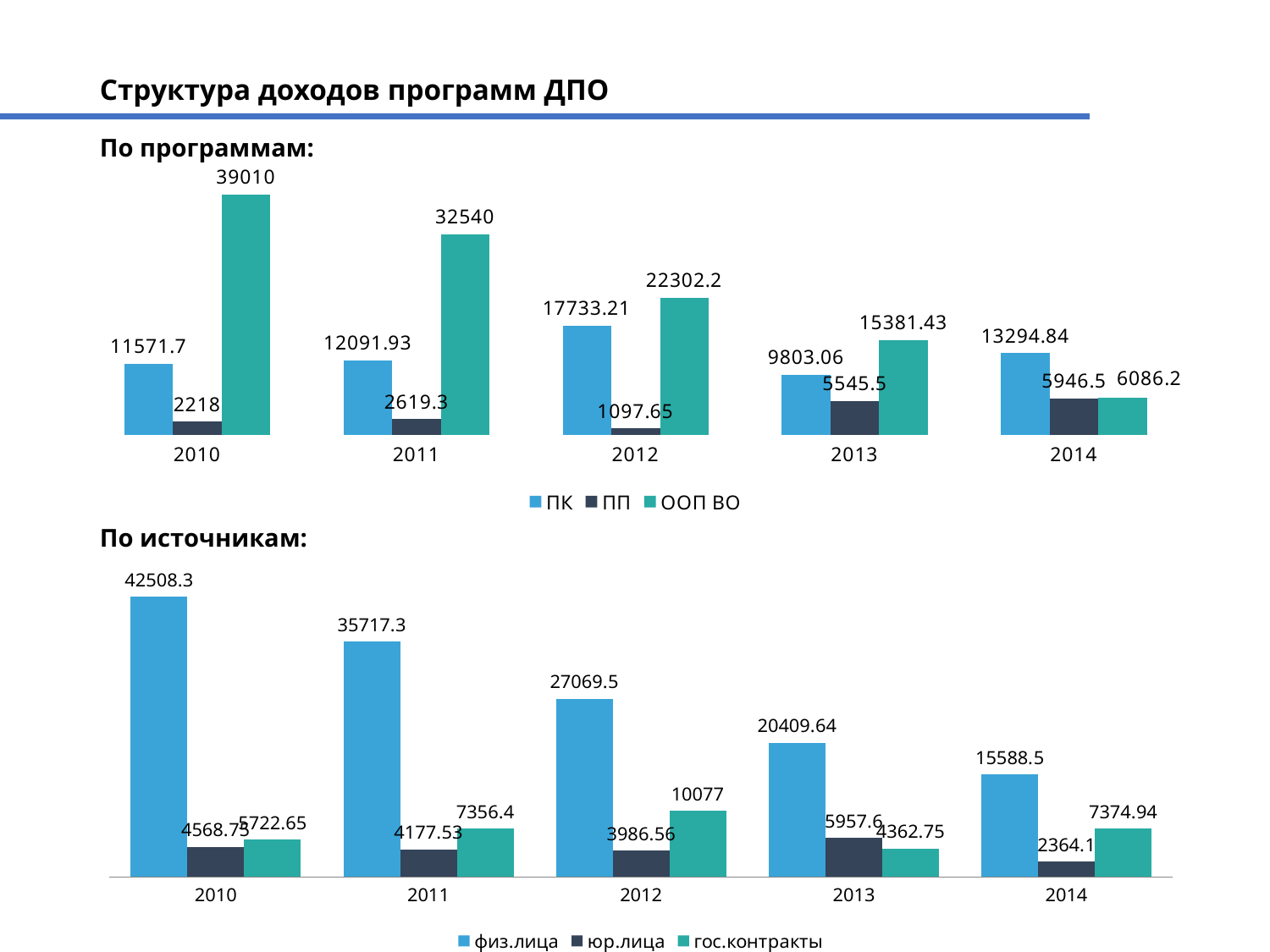
In the 'По программам' chart, which year has the lowest value for ПП? 2012 In the 'По программам' chart, what is the value for ООП ВО in 2010? 39010 In the 'По источникам' chart, which is larger in 2013: юр.лица or гос.контракты? юр.лица In the 'По источникам' chart, what is the value for гос.контракты in 2012? 10077 In the 'По программам' chart, how many series does the legend list? 3 What kind of chart is the 'По источникам' chart? bar chart In the 'По программам' chart, does the value for ООП ВО rise or fall from 2010 to 2014? fall In the 'По источникам' chart, what is the difference between физ.лица in 2010 and физ.лица in 2014? 26919.8 In the 'По программам' chart, which year has the highest value for ООП ВО? 2010 In the 'По программам' chart, what is the value for ПК in 2012? 17733.21 In the 'По программам' chart, what is the value for ПП in 2014? 5946.5 In the 'По источникам' chart, what is the value for физ.лица in 2013? 20409.64